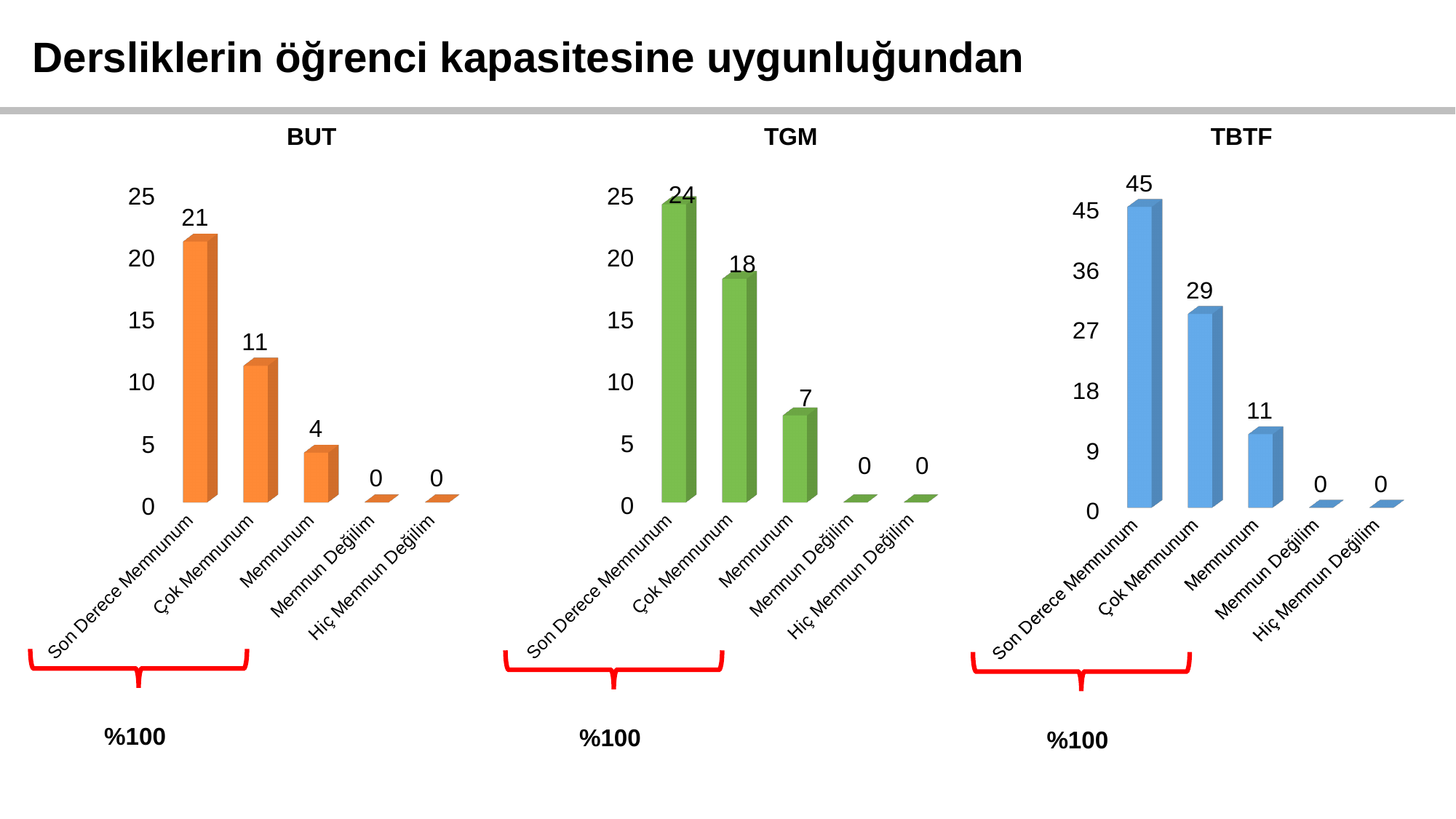
In the TBTF chart, what is the difference between Son Derece Memnunum and Çok Memnunum? 16 What colour are the bars in the TBTF chart? blue In the TGM chart, what is the value for Çok Memnunum? 18 How many categories does the BUT chart show? 5 In the TBTF chart, what is the value for Memnunum? 11 In the BUT chart, what is the value for Son Derece Memnunum? 21 In the TBTF chart, do the values rise or fall from left to right along the x axis? fall In the TBTF chart, which category has the highest value? Son Derece Memnunum What kind of chart is the TGM chart? bar chart In the BUT chart, what is the difference between Son Derece Memnunum and Çok Memnunum? 10 In the TGM chart, which is larger, Çok Memnunum or Memnunum? Çok Memnunum In the TGM chart, which category has the highest value? Son Derece Memnunum